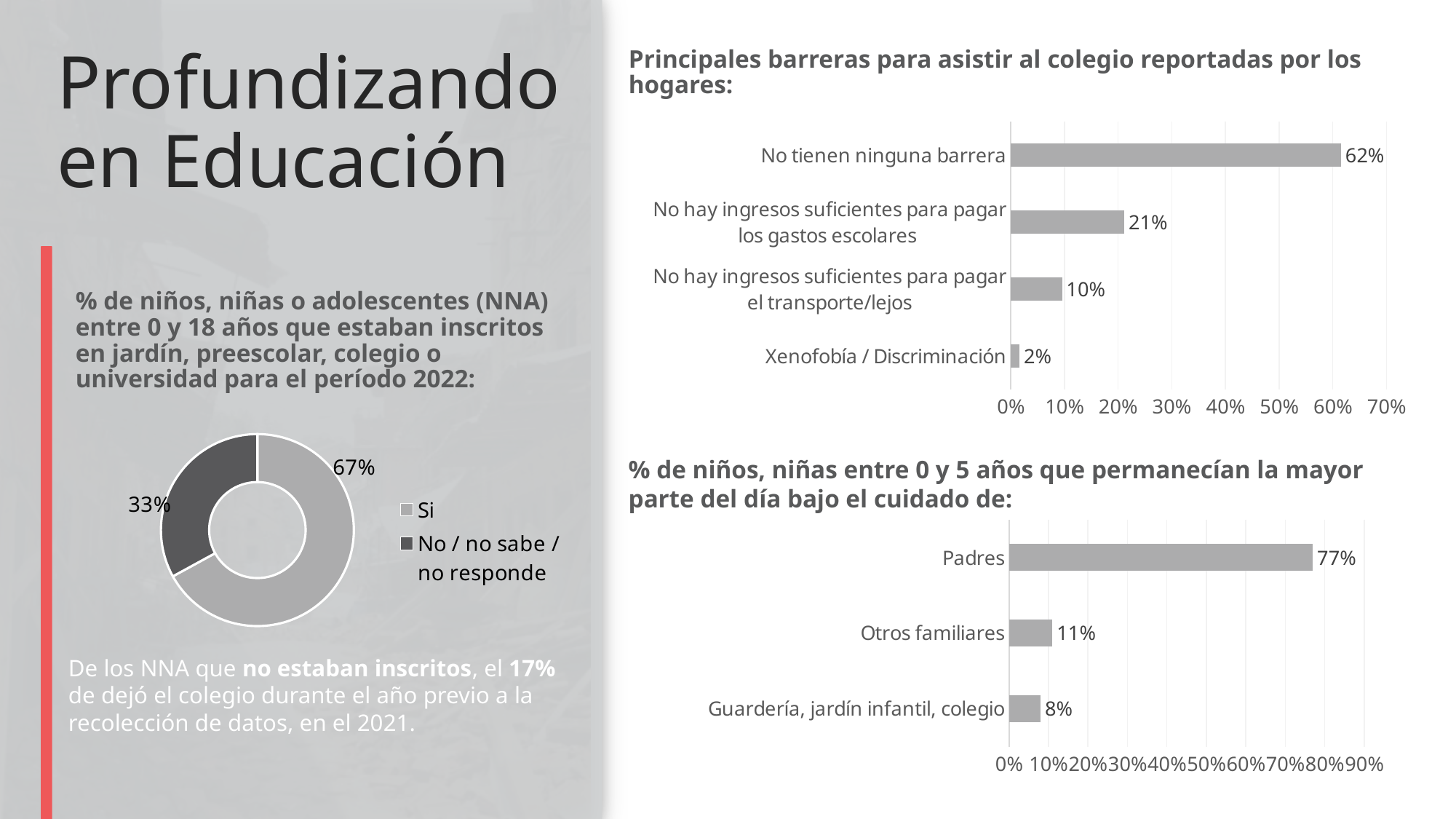
In the '% de niños, niñas entre 0 y 5 años que permanecían la mayor parte del día bajo el cuidado de' chart, what is the highest value shown on the x axis? 90% In the 'Principales barreras para asistir al colegio reportadas por los hogares' chart, which category has the lowest value? Xenofobía / Discriminación In the donut chart on the left, how many entries does the legend list? 2 In the 'Principales barreras para asistir al colegio reportadas por los hogares' chart, what is the value for 'No tienen ninguna barrera'? 62% In the '% de niños, niñas entre 0 y 5 años que permanecían la mayor parte del día bajo el cuidado de' chart, what is the difference between 'Padres' and 'Otros familiares'? 66% In the donut chart on the left, what percentage is shown for 'Si'? 67% What kind of chart is the 'Principales barreras para asistir al colegio reportadas por los hogares' chart? Bar chart In the 'Principales barreras para asistir al colegio reportadas por los hogares' chart, what is the difference between 'No hay ingresos suficientes para pagar los gastos escolares' and 'No hay ingresos suficientes para pagar el transporte/lejos'? 11% In the '% de niños, niñas entre 0 y 5 años que permanecían la mayor parte del día bajo el cuidado de' chart, which is larger: 'Otros familiares' or 'Guardería, jardín infantil, colegio'? Otros familiares In the donut chart on the left, what percentage is shown for 'No / no sabe / no responde'? 33% In the '% de niños, niñas entre 0 y 5 años que permanecían la mayor parte del día bajo el cuidado de' chart, what is the value for 'Padres'? 77% In the 'Principales barreras para asistir al colegio reportadas por los hogares' chart, how many categories are shown? 4